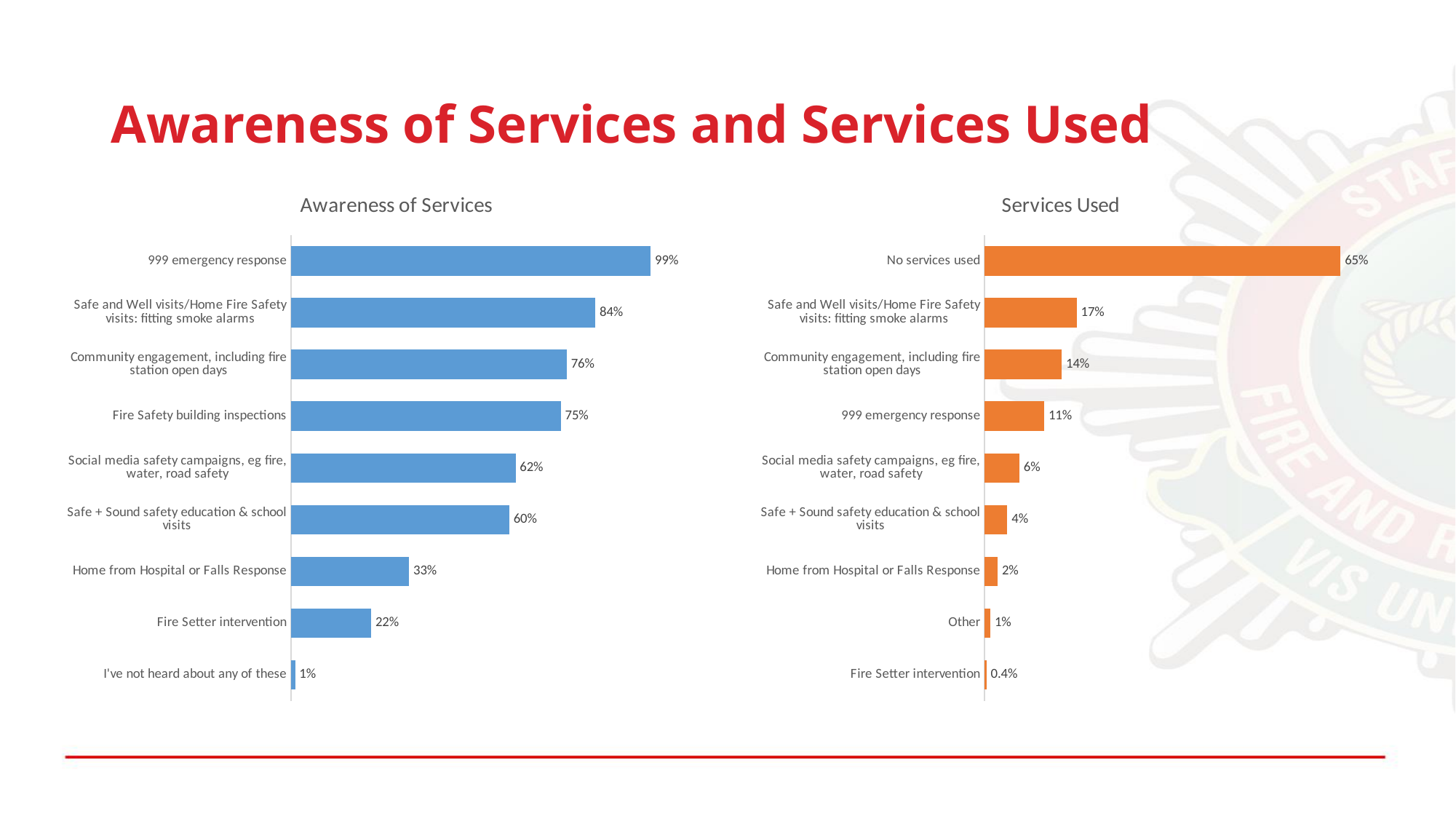
In the Awareness of Services chart, which category has the lowest value? I've not heard about any of these In the Services Used chart, what is the value for Fire Setter intervention? 0.4% How many categories are shown in the Awareness of Services chart? 9 What kind of chart is the Services Used chart? Bar chart How many categories are shown in the Services Used chart? 9 In the Services Used chart, what is the difference between the values for No services used and Safe and Well visits/Home Fire Safety visits: fitting smoke alarms? 48% In the Services Used chart, which category has the highest value? No services used In the Awareness of Services chart, what is the value for Home from Hospital or Falls Response? 33% In the Awareness of Services chart, what is the difference between the values for 999 emergency response and Fire Setter intervention? 77% In the Awareness of Services chart, what is the value for 999 emergency response? 99% What colour are the bars in the Awareness of Services chart? Blue In the Services Used chart, which is larger: the value for Community engagement, including fire station open days or the value for 999 emergency response? Community engagement, including fire station open days